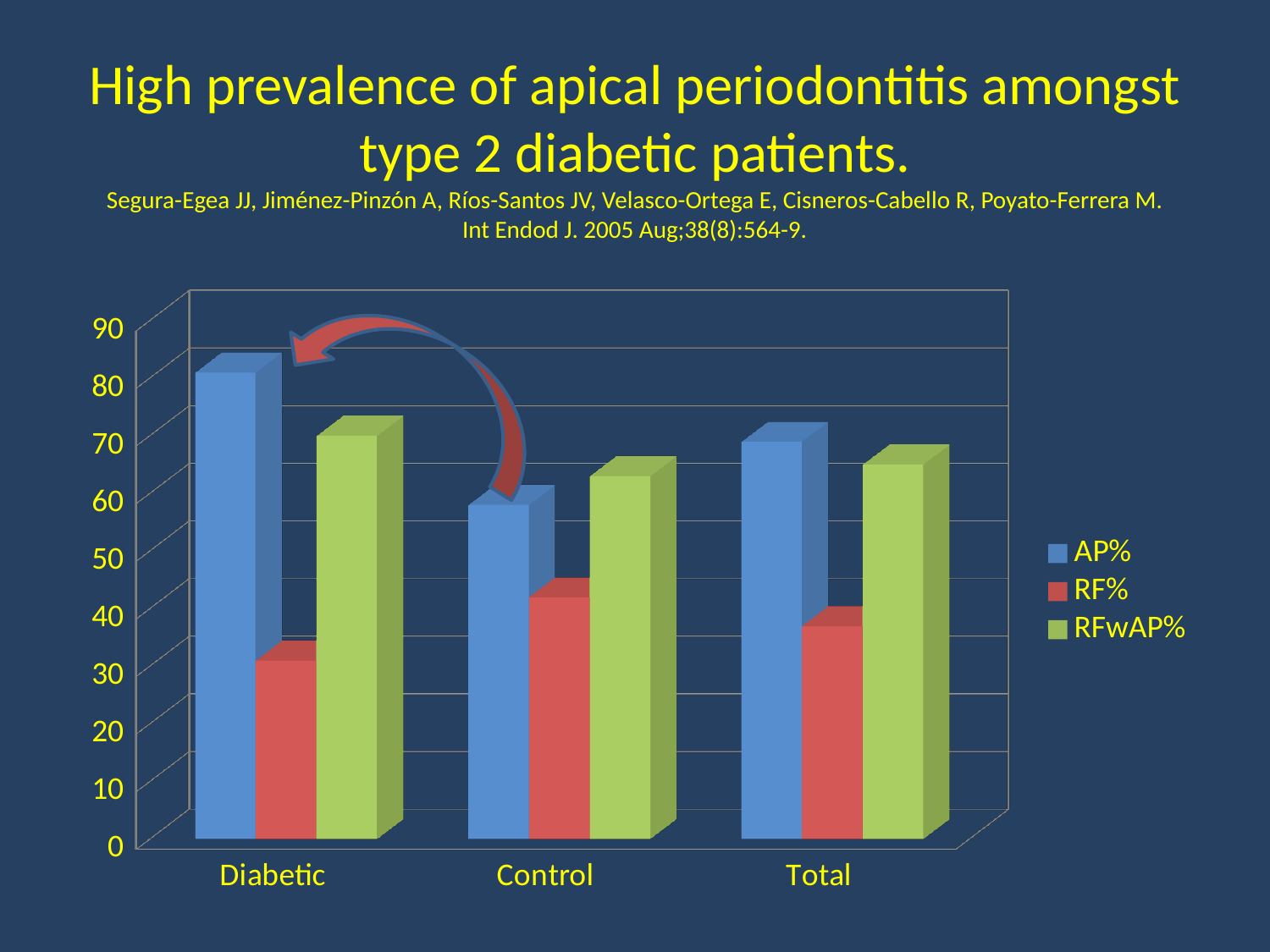
Is the RF% value for Diabetic greater or less than 40? less Which category has the highest RF% value? Control Is the AP% value for Diabetic greater or less than 70? greater Which is larger, the AP% value for Diabetic or the AP% value for Control? Diabetic What kind of chart is shown on the slide? bar chart How many categories are shown on the x axis? 3 How many series does the legend list? 3 Is the AP% value for Control greater or less than 70? less Which colour represents the AP% series in the legend? blue Which category has the highest AP% value? Diabetic Which category has the lowest RF% value? Diabetic